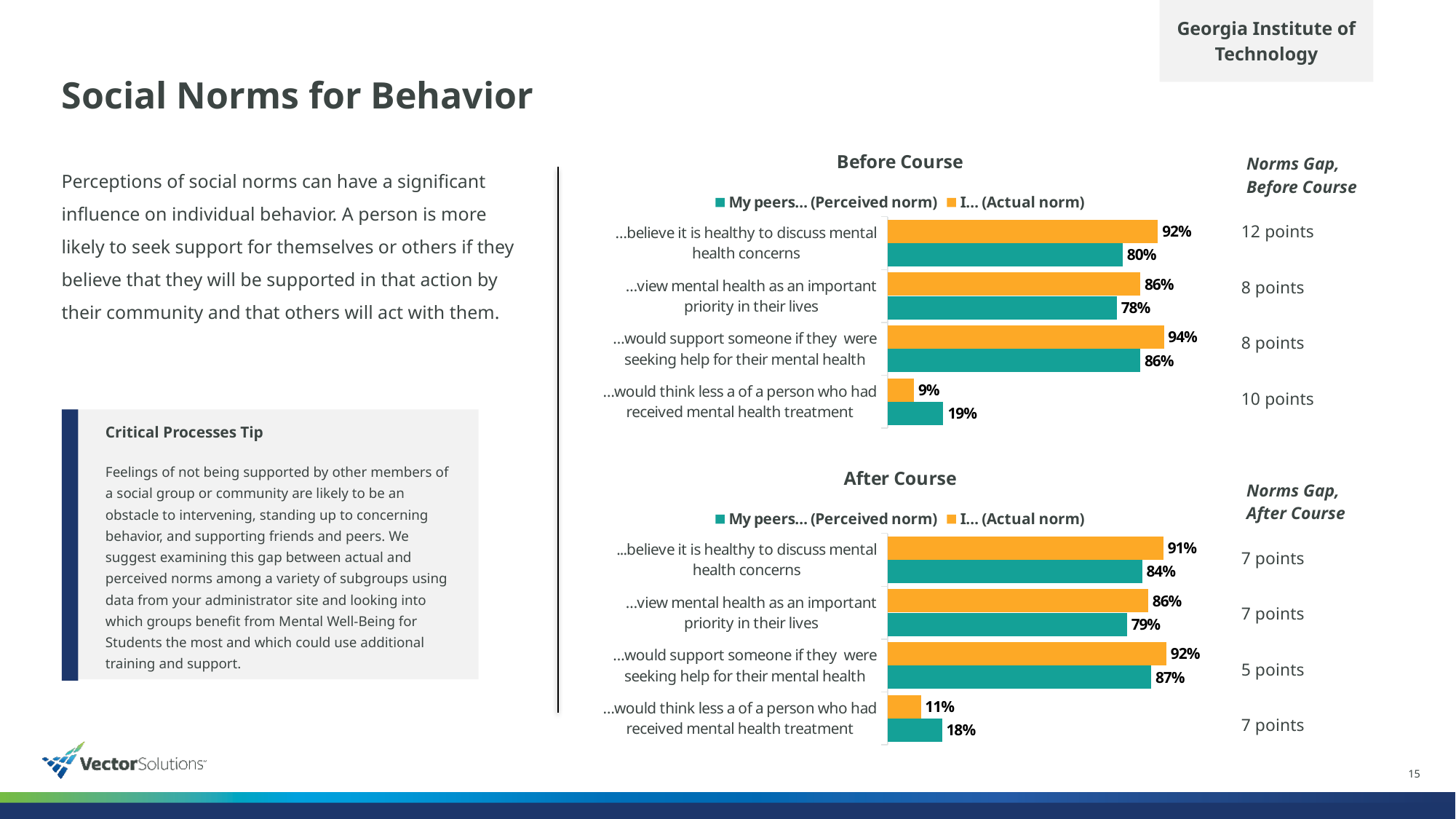
In the Before Course chart, what is the difference between the 'I... (Actual norm)' and 'My peers... (Perceived norm)' values for '...believe it is healthy to discuss mental health concerns'? 12% In the Before Course chart, what is the value for 'I... (Actual norm)' for '...believe it is healthy to discuss mental health concerns'? 92% In the After Course chart, what is the value for 'I... (Actual norm)' for '...would support someone if they were seeking help for their mental health'? 92% In the After Course chart, what is the difference between the 'My peers... (Perceived norm)' and 'I... (Actual norm)' values for '...would think less a of a person who had received mental health treatment'? 7% In the After Course chart, which is larger for '...believe it is healthy to discuss mental health concerns': 'I... (Actual norm)' or 'My peers... (Perceived norm)'? I... (Actual norm) In the Before Course chart, which category has the highest 'I... (Actual norm)' value? ...would support someone if they were seeking help for their mental health In the After Course chart, what is the value for 'My peers... (Perceived norm)' for '...view mental health as an important priority in their lives'? 79% In the After Course chart, which category has the lowest 'My peers... (Perceived norm)' value? ...would think less a of a person who had received mental health treatment In the Before Course chart, what is the value for 'My peers... (Perceived norm)' for '...would think less a of a person who had received mental health treatment'? 19% What type of chart is the Before Course chart? Bar chart How many categories does the Before Course chart show? 4 How many series does the legend of the After Course chart list? 2